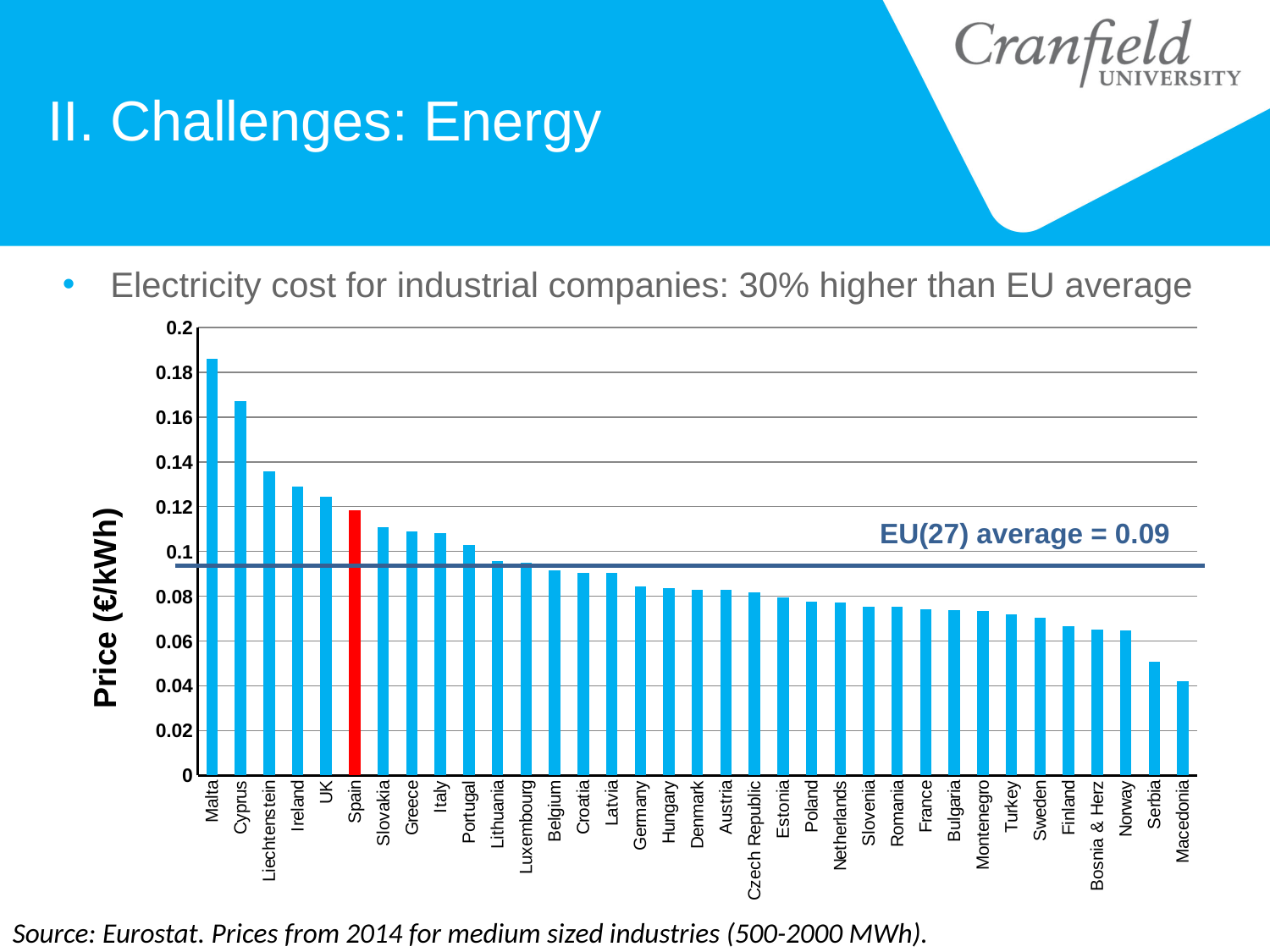
What kind of chart is shown on the slide? bar chart Do the bar values rise or fall from left to right along the x axis? fall How many countries are shown in the chart? 35 What is the EU(27) average price marked by the horizontal line on the chart? 0.09 Which country has the lowest electricity price in the chart? Macedonia Is the value for Malta greater or less than 0.18? greater Is the value for Spain greater or less than 0.1? greater Is the value for Macedonia greater or less than 0.06? less Which has a higher electricity price, Serbia or Macedonia? Serbia Which country has the highest electricity price in the chart? Malta Which has a higher electricity price, Spain or Germany? Spain